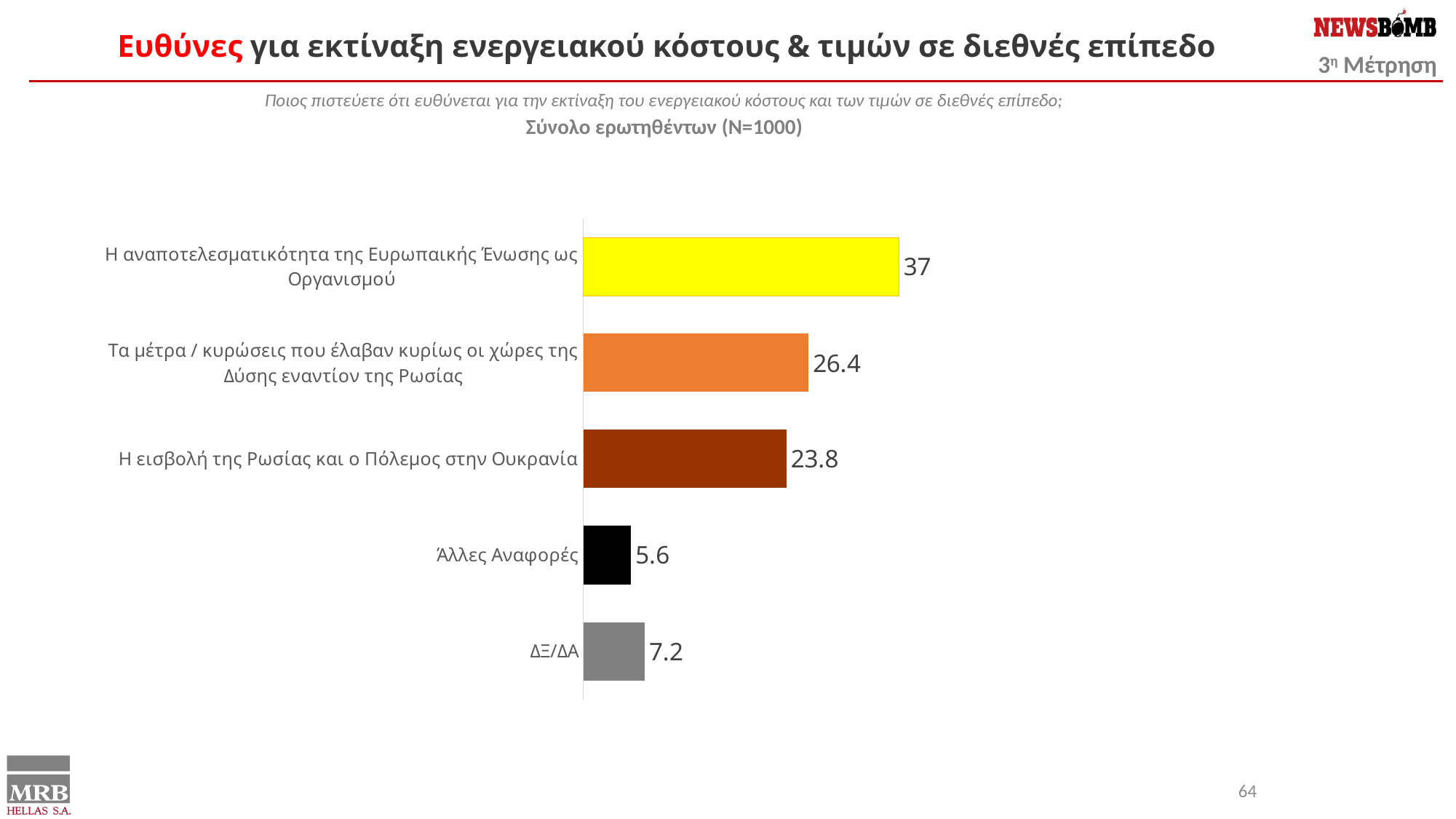
What is the value for "Τα μέτρα / κυρώσεις που έλαβαν κυρίως οι χώρες της Δύσης εναντίον της Ρωσίας"? 26.4 What is the difference between the values for "Η αναποτελεσματικότητα της Ευρωπαικής Ένωσης ως Οργανισμού" and "Τα μέτρα / κυρώσεις που έλαβαν κυρίως οι χώρες της Δύσης εναντίον της Ρωσίας"? 10.6 What is the difference between the values for "Τα μέτρα / κυρώσεις που έλαβαν κυρίως οι χώρες της Δύσης εναντίον της Ρωσίας" and "Η εισβολή της Ρωσίας και ο Πόλεμος στην Ουκρανία"? 2.6 What is the value for "Η εισβολή της Ρωσίας και ο Πόλεμος στην Ουκρανία"? 23.8 What is the value for "Η αναποτελεσματικότητα της Ευρωπαικής Ένωσης ως Οργανισμού"? 37 Which category has the lowest value? Άλλες Αναφορές How many categories are shown in the chart? 5 What kind of chart is shown on the slide? Bar chart What colour is the bar for "Η εισβολή της Ρωσίας και ο Πόλεμος στην Ουκρανία"? Dark red-brown Which category has the highest value? Η αναποτελεσματικότητα της Ευρωπαικής Ένωσης ως Οργανισμού What is the value for "ΔΞ/ΔΑ"? 7.2 Which is larger: the value for "Άλλες Αναφορές" or the value for "ΔΞ/ΔΑ"? ΔΞ/ΔΑ